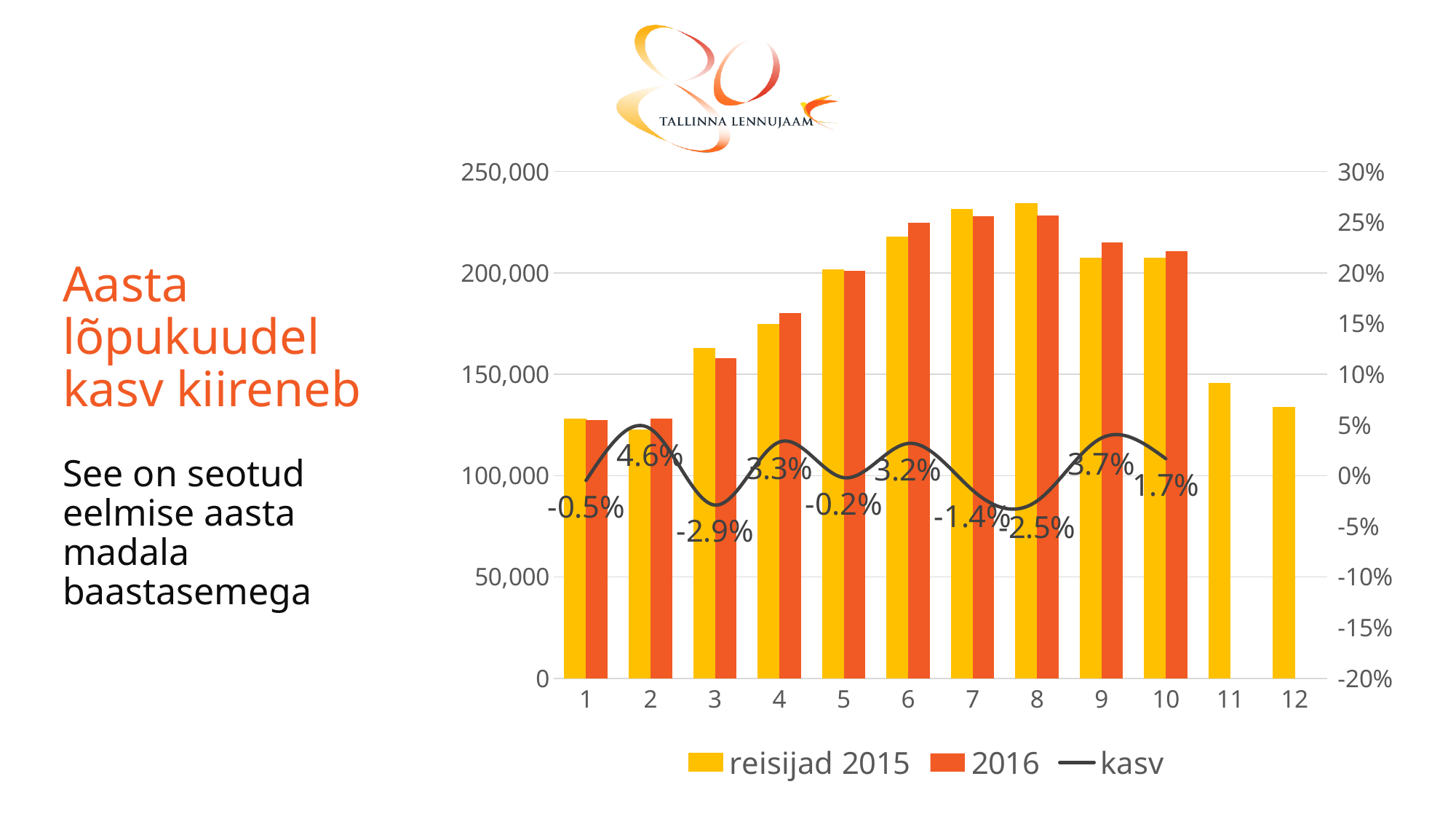
What is the kasv value for month 3? -2.9% Is the reisijad 2015 value for month 12 greater or less than 150,000? less How many series does the legend list? 3 How many months are shown on the x axis? 12 Which month has the lowest kasv value? 3 What is the kasv value for month 2? 4.6% Which month has the highest reisijad 2015 bar? 8 Which month has the highest kasv value? 2 What is the kasv value for month 9? 3.7% Which is larger, the kasv value for month 9 or for month 10? month 9 Is the reisijad 2015 value for month 8 greater or less than 200,000? greater What is the difference between the kasv values for month 2 and month 9? 0.9 percentage points